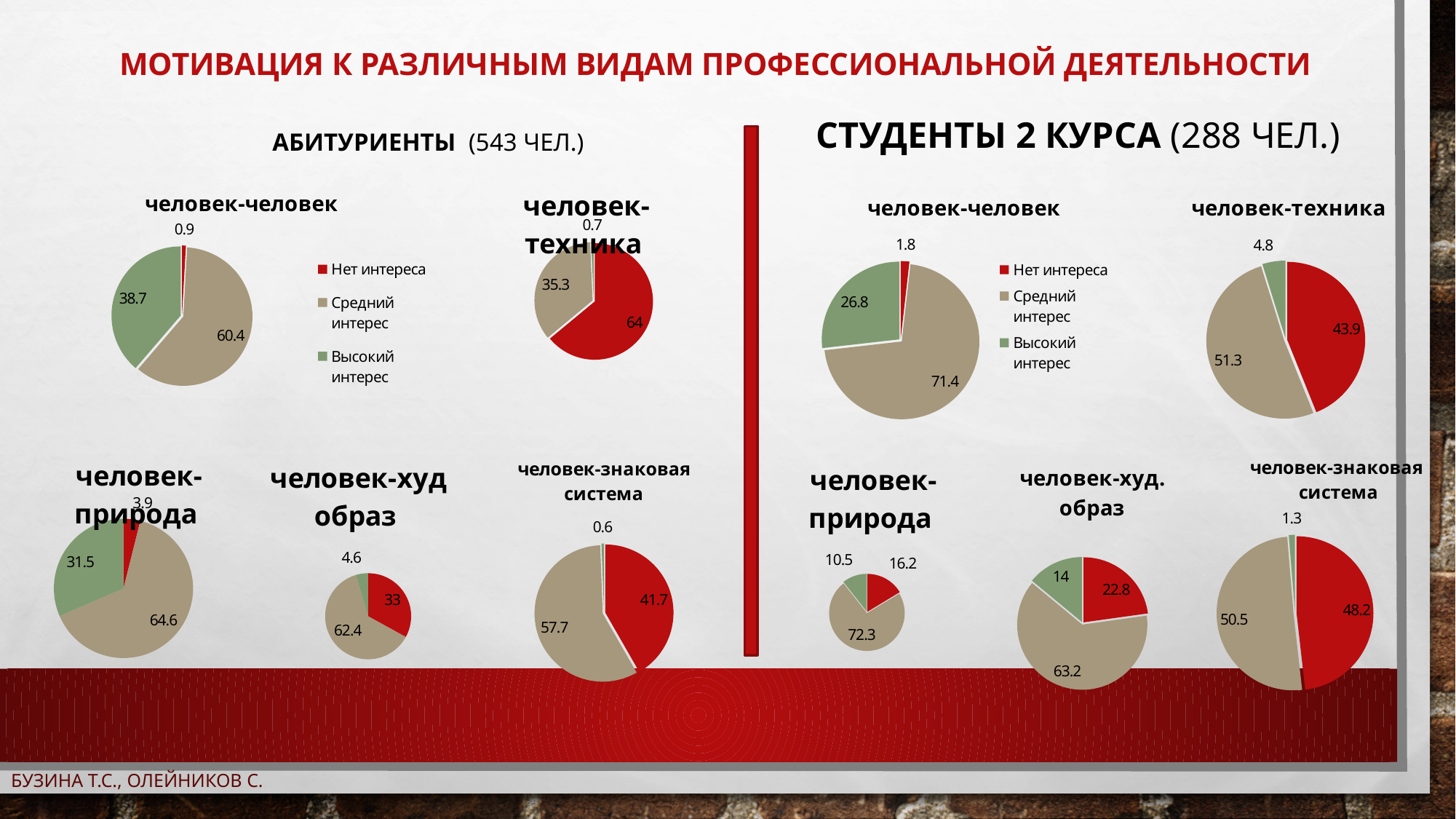
In the Абитуриенты chart titled человек-природа, which is larger: Средний интерес or Высокий интерес? Средний интерес Which colour represents Нет интереса in the legend? Red How many entries does the legend next to the Абитуриенты человек-человек chart list? 3 In the Студенты 2 курса chart titled человек-техника, what is the value for Нет интереса? 43.9 In the Студенты 2 курса chart titled человек-худ. образ, what is the difference between Средний интерес and Нет интереса? 40.4 In the Абитуриенты chart titled человек-человек, what is the value for Средний интерес? 60.4 How many slices does the Студенты 2 курса chart titled человек-человек have? 3 In the Студенты 2 курса chart titled человек-природа, what is the value for Высокий интерес? 10.5 In the Абитуриенты chart titled человек-техника, which category has the smallest slice? Высокий интерес In the Абитуриенты chart titled человек-знаковая система, which category has the largest slice? Средний интерес In the Абитуриенты chart titled человек-худ образ, what is the value for Нет интереса? 33 What type of chart is used for человек-знаковая система in the Студенты 2 курса section? Pie chart